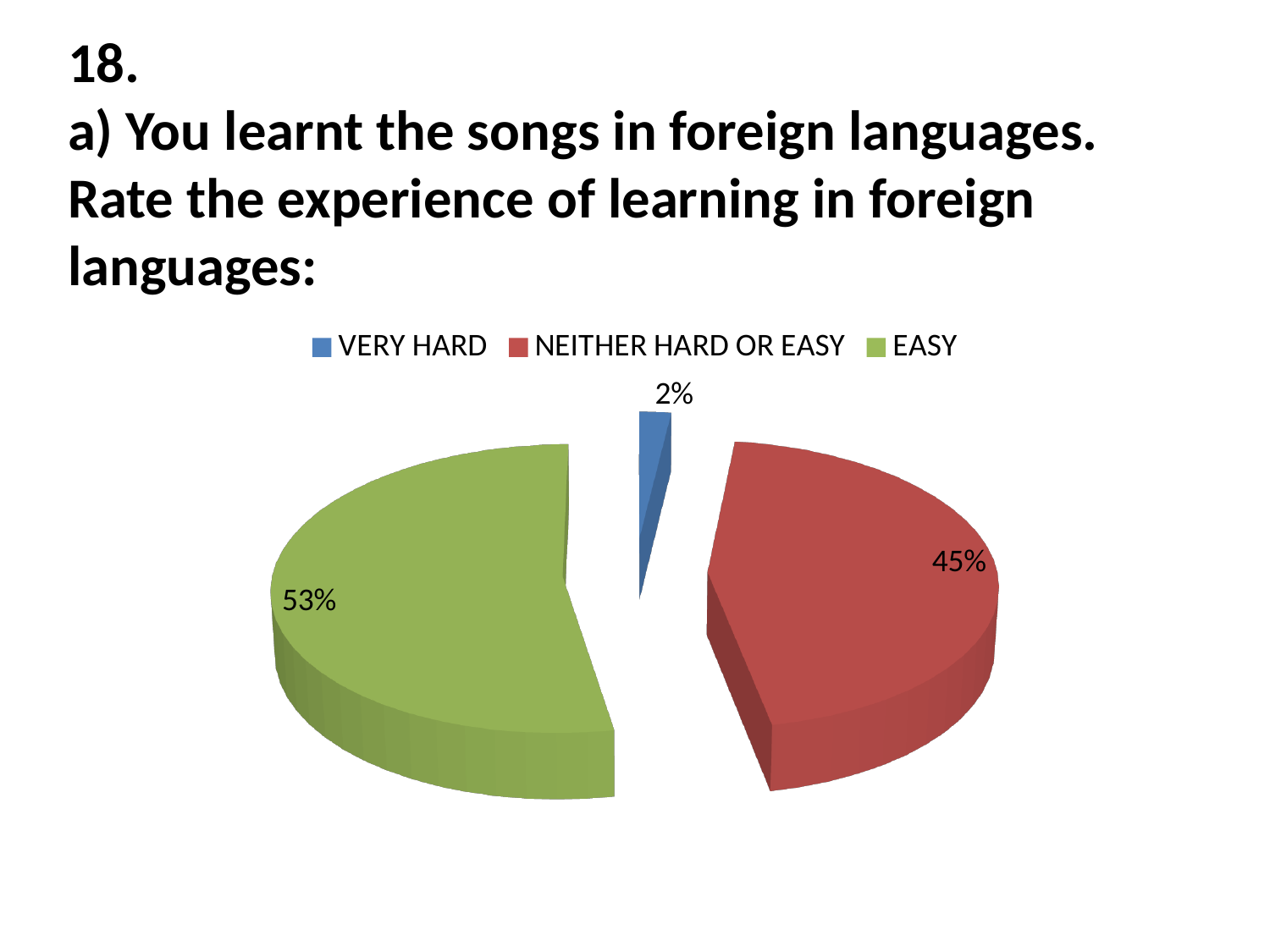
Which category has the smallest share of the pie? VERY HARD What percentage of respondents rated the experience as EASY? 53% Which colour represents the VERY HARD category in the pie chart? blue What percentage of respondents rated the experience as VERY HARD? 2% How many categories does the pie chart show? 3 What is the difference in percentage points between EASY and NEITHER HARD OR EASY? 8 Which is larger, the share for EASY or the share for NEITHER HARD OR EASY? EASY Which category has the largest share of the pie? EASY What is the difference in percentage points between NEITHER HARD OR EASY and VERY HARD? 43 What percentage of respondents rated the experience as NEITHER HARD OR EASY? 45% What kind of chart is shown on the slide? pie chart Which colour represents the EASY category in the pie chart? green